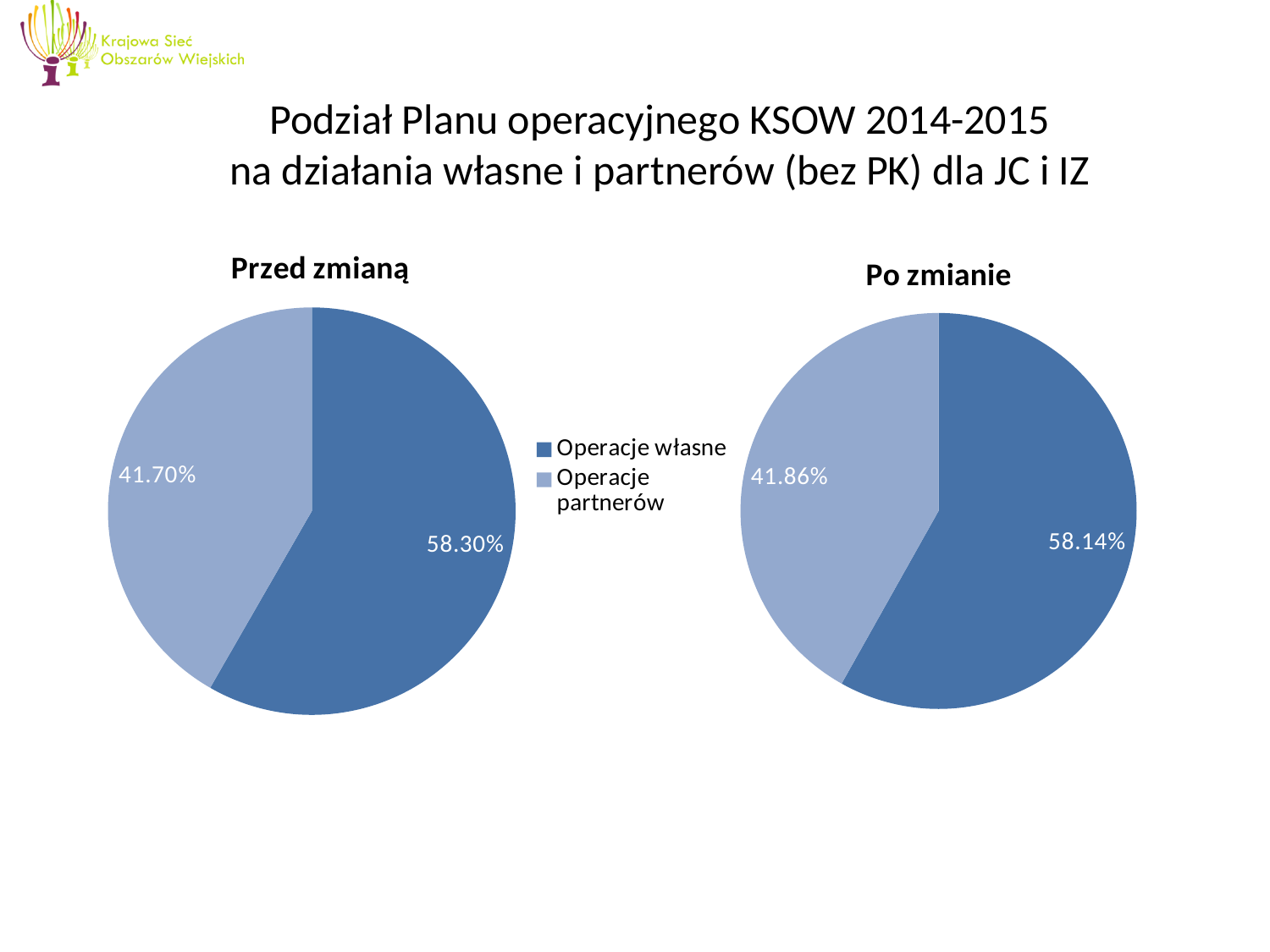
In the "Przed zmianą" chart, which category has the largest slice? Operacje własne What kind of chart is the "Przed zmianą" chart? Pie chart In the "Po zmianie" chart, which category has the smallest slice? Operacje partnerów In the "Po zmianie" chart, which is larger: Operacje własne or Operacje partnerów? Operacje własne How many slices does the "Po zmianie" chart have? 2 In the "Przed zmianą" chart, what share does Operacje partnerów have? 41.70% In the "Po zmianie" chart, what share does Operacje własne have? 58.14% In the "Przed zmianą" chart, what is the difference between the Operacje własne and Operacje partnerów shares? 16.60% In the "Przed zmianą" chart, what share does Operacje własne have? 58.30% In the "Po zmianie" chart, what is the difference between the Operacje własne and Operacje partnerów shares? 16.28% How many entries does the legend list? 2 In the "Po zmianie" chart, what share does Operacje partnerów have? 41.86%